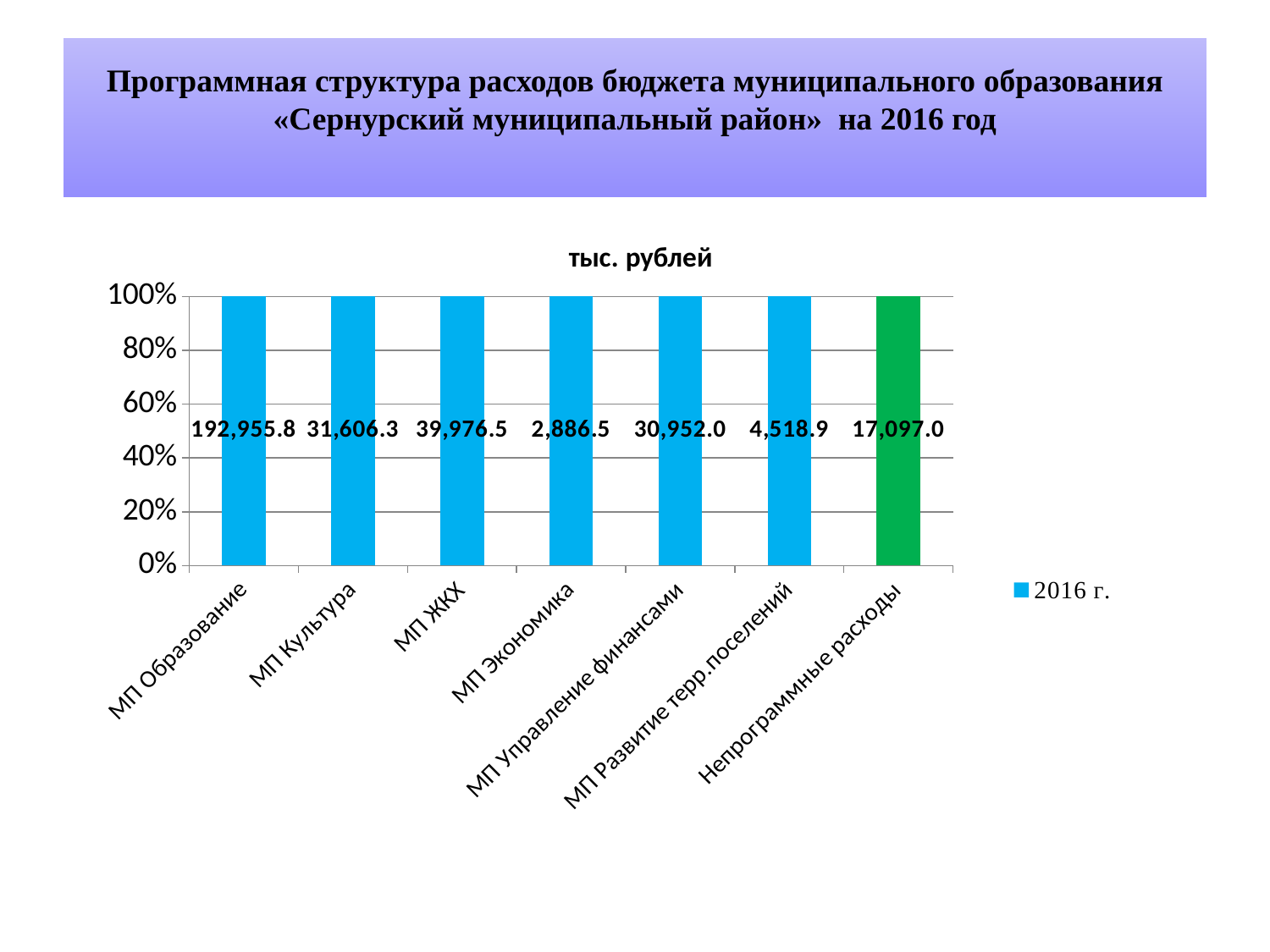
What is the difference between the labelled values for Непрограммные расходы and МП Развитие терр.поселений? 12,578.1 Which category has the highest labelled value? МП Образование What is the data label value for МП Образование? 192,955.8 What kind of chart is shown on the slide? Bar chart What is the data label value for Непрограммные расходы? 17,097.0 What is the data label value for МП Управление финансами? 30,952.0 How many series does the legend list? 1 Which has the larger labelled value, МП Культура or МП Управление финансами? МП Культура Which category has the lowest labelled value? МП Экономика What is the data label value for МП Экономика? 2,886.5 What is the difference between the labelled values for МП ЖКХ and МП Культура? 8,370.2 How many categories are shown on the x axis? 7